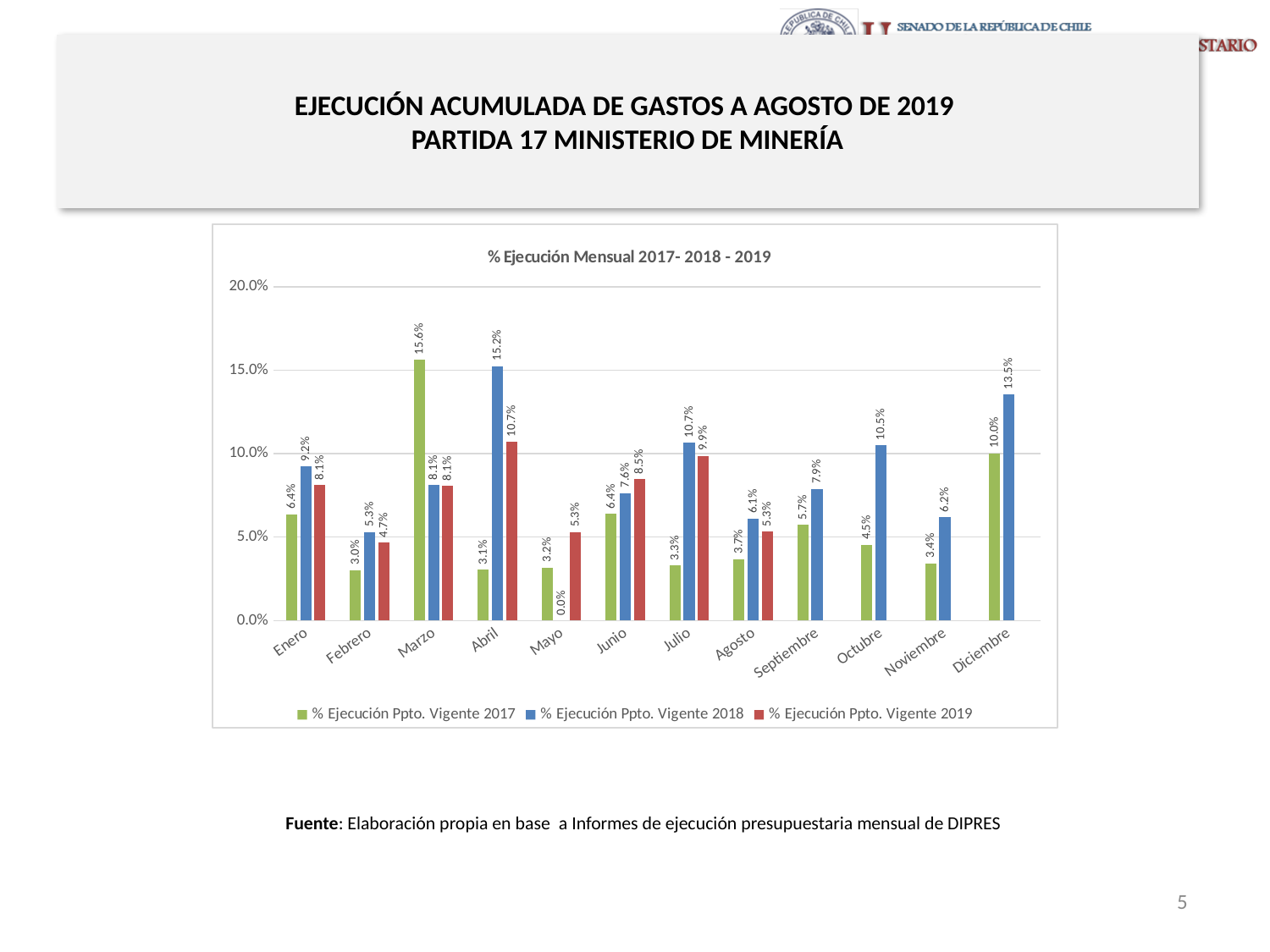
What is the title of the chart? % Ejecución Mensual 2017- 2018 - 2019 In which month is the % Ejecución Ppto. Vigente 2018 series lowest? Mayo What is the value for % Ejecución Ppto. Vigente 2017 in Diciembre? 10.0% What is the difference between the 2018 and 2017 values in Julio? 7.4% Is the value for % Ejecución Ppto. Vigente 2018 in Diciembre greater or less than 10.0%? greater How many months are shown on the x axis? 12 In which month is the % Ejecución Ppto. Vigente 2017 series highest? Marzo What kind of chart is shown on the slide? Bar chart Which is larger in Junio: the 2018 value or the 2019 value? 2019 value What is the value for % Ejecución Ppto. Vigente 2018 in Abril? 15.2% How many series does the legend list? 3 What is the value for % Ejecución Ppto. Vigente 2019 in Julio? 9.9%